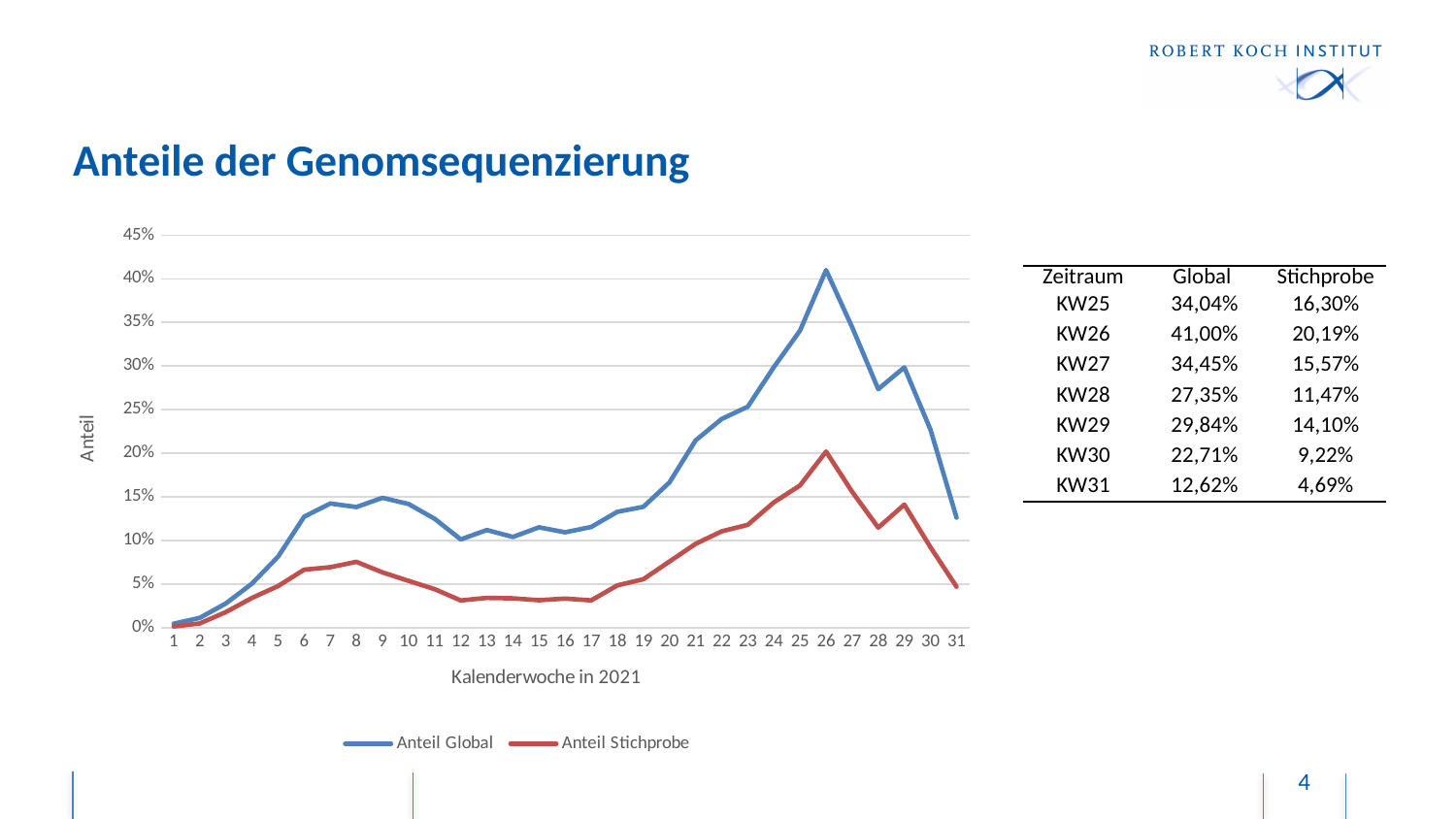
How many calendar weeks are plotted along the x axis? 31 Do the values of Anteil Global rise or fall from calendar week 29 to week 31? fall What is the difference between the Global and Stichprobe shares in KW26? 20,81% Is the value of Anteil Stichprobe in calendar week 12 greater or less than 5%? less According to the table, what is the Stichprobe share in KW31? 4,69% What is the title of the x axis? Kalenderwoche in 2021 What type of chart is shown on the slide? line chart How many series does the chart legend list? 2 In which calendar week does Anteil Global reach its highest value? 26 According to the table, what is the Global share in KW26? 41,00% Which series has the higher value in calendar week 20, Anteil Global or Anteil Stichprobe? Anteil Global Is the value of Anteil Global in calendar week 10 greater or less than 10%? greater